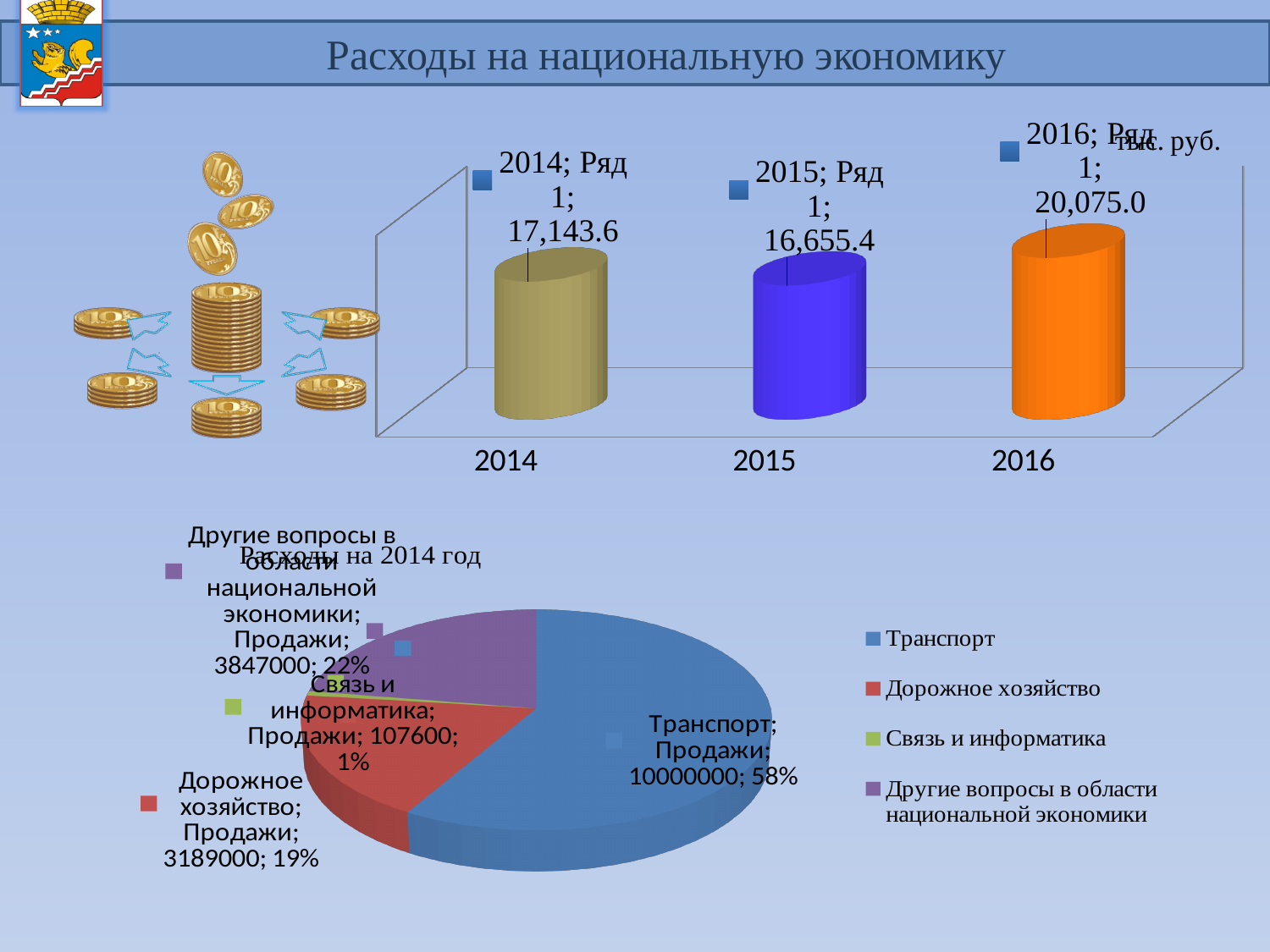
In the pie chart 'Расходы на 2014 год', which is larger: Дорожное хозяйство or Другие вопросы в области национальной экономики? Другие вопросы в области национальной экономики In the top bar chart, what is the value for 2015? 16,655.4 In the pie chart 'Расходы на 2014 год', which category has the smallest slice? Связь и информатика In the top bar chart, what is the value for 2016? 20,075.0 In the top bar chart, which year has the lowest value? 2015 In the top bar chart, which year has the highest value? 2016 In the pie chart 'Расходы на 2014 год', what share does Транспорт have? 58% What kind of chart is the top chart on the slide? bar chart In the top bar chart, what is the difference between the values for 2016 and 2014? 2,931.4 In the pie chart 'Расходы на 2014 год', what is the value for Дорожное хозяйство? 3189000 How many entries does the legend of the pie chart 'Расходы на 2014 год' list? 4 In the top bar chart, how many years are plotted? 3